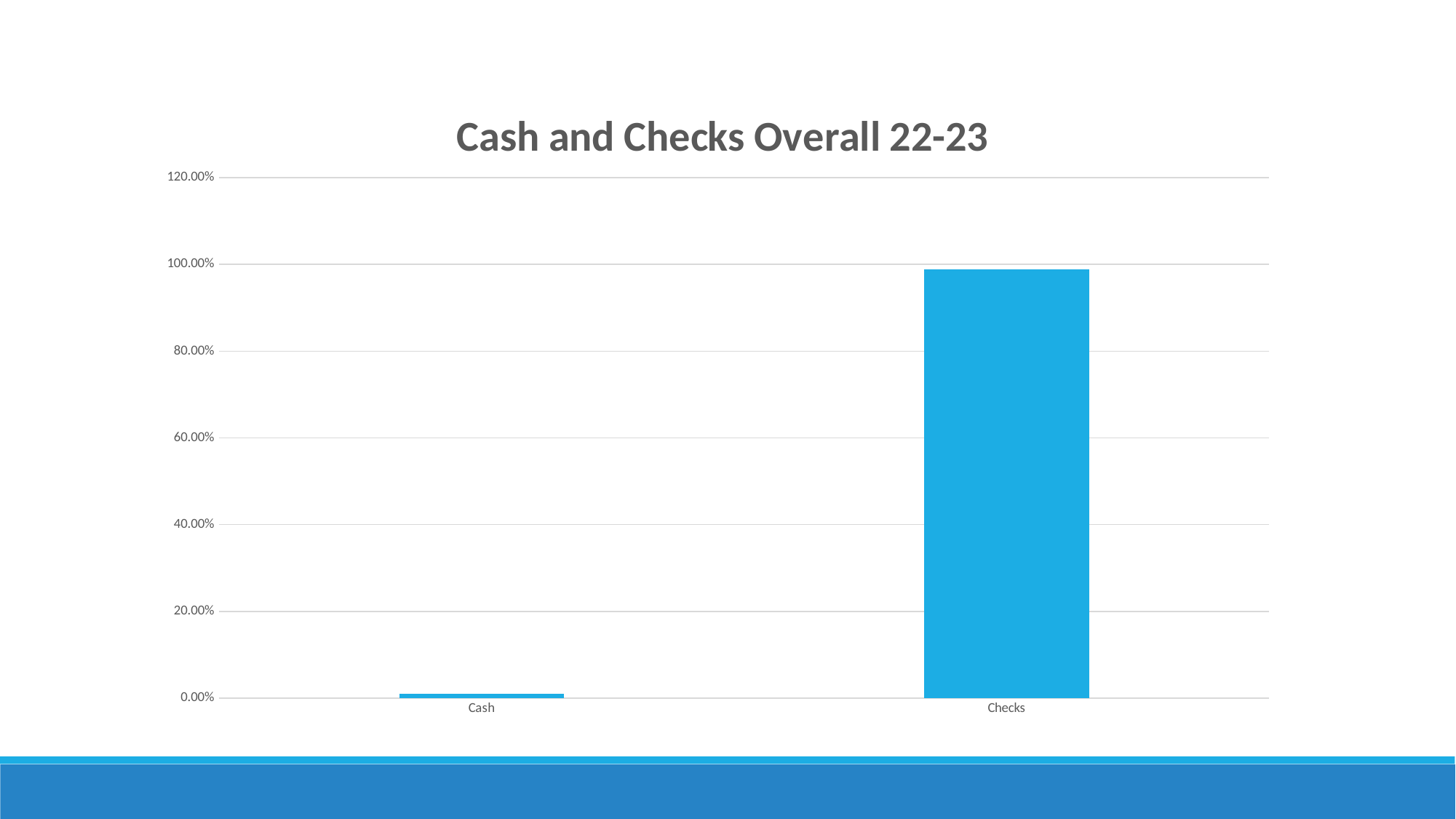
What is the highest value shown on the y axis? 120.00% Which is larger, the value for Cash or the value for Checks? Checks Which category has the highest value? Checks Is the value for Cash greater or less than 20.00%? less What is the title of the chart? Cash and Checks Overall 22-23 Do the values rise or fall from Cash to Checks along the x axis? rise Is the value for Checks greater or less than 100.00%? less How many categories are shown on the x axis? 2 Is the value for Checks greater or less than 80.00%? greater Which category has the lowest value? Cash What kind of chart is shown on the slide? bar chart